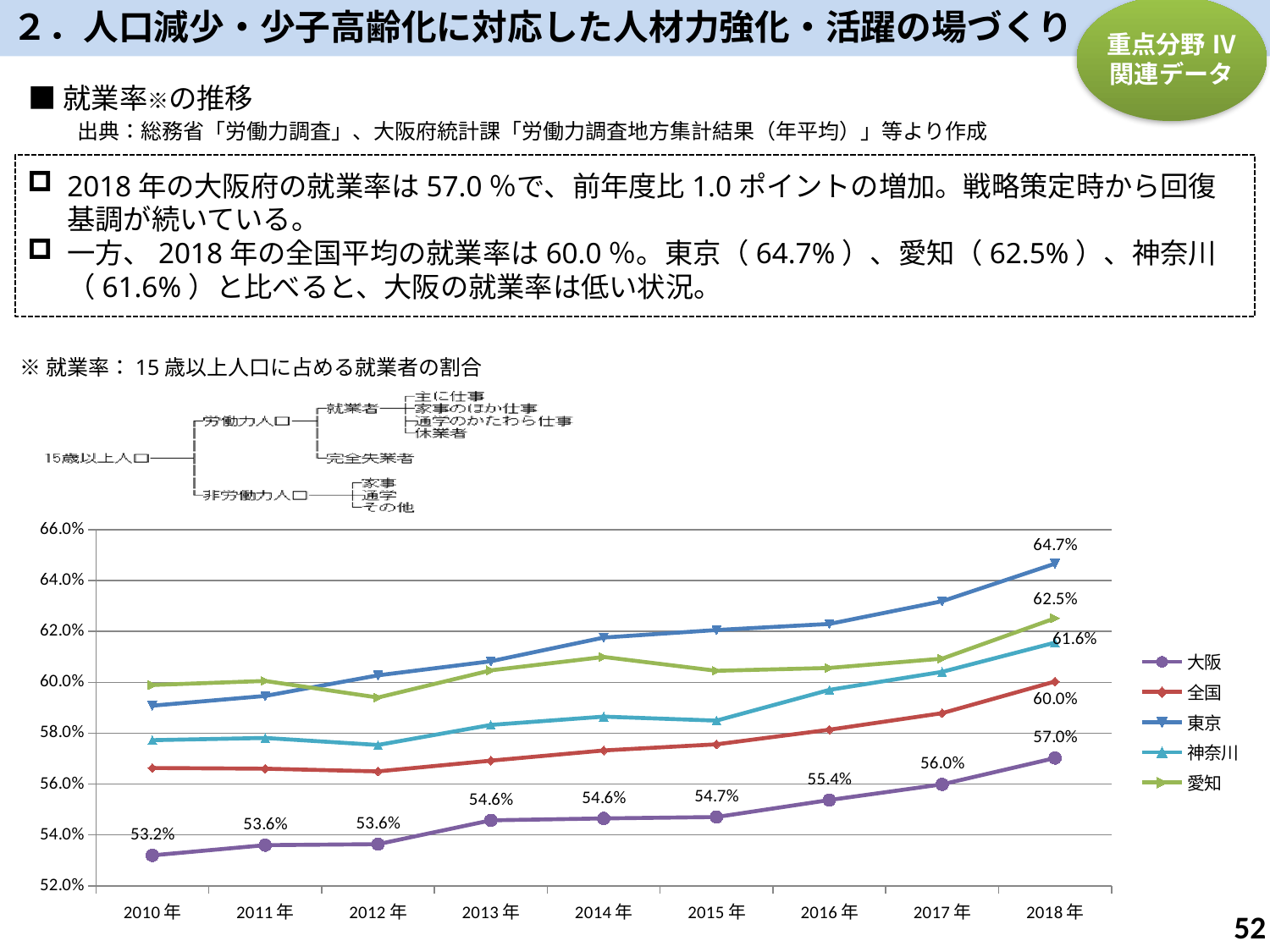
Is the value for 全国 in 2010年 greater or less than 58.0%? less Which series has the highest value in 2018年? 東京 What is the difference between the 東京 and 大阪 values in 2018年? 7.7 points What kind of chart is shown on the slide? line chart Does the 大阪 series rise or fall from 2010年 to 2018年? rise Which is larger in 2018年, the value for 愛知 or the value for 神奈川? 愛知 Which series has the lowest value in 2018年? 大阪 How many series does the legend list? 5 How many years are plotted along the x axis? 9 What is the value for 大阪 in 2010年? 53.2% What is the value for 大阪 in 2018年? 57.0% What is the value for 東京 in 2018年? 64.7%